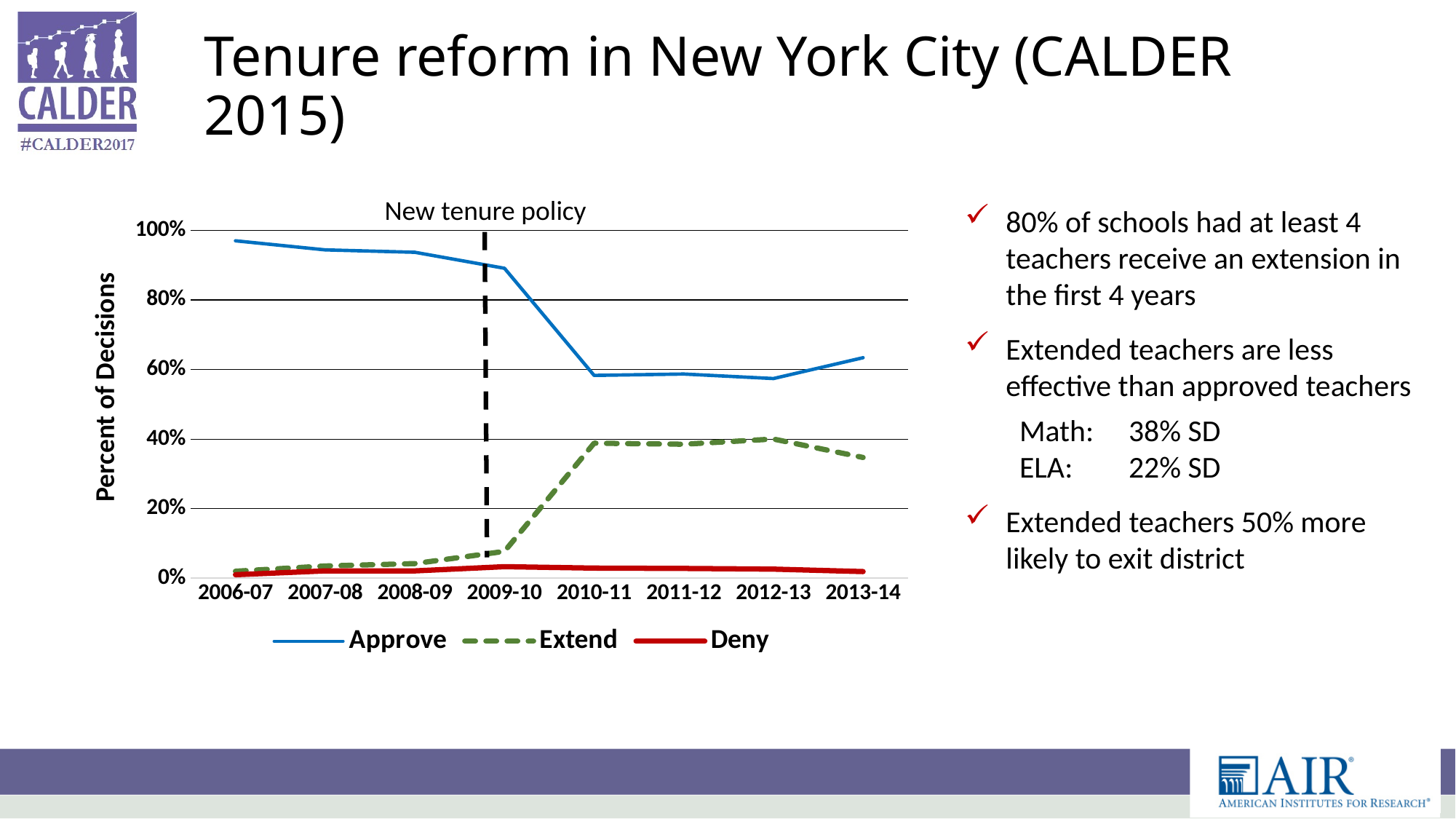
Does the Extend line rise or fall between 2008-09 and 2010-11? Rise Does the Approve line rise or fall between 2006-07 and 2010-11? Fall How many series does the chart's legend list? 3 Is the value for Approve in 2006-07 greater or less than 80%? greater Which series has the highest value in 2013-14? Approve Which series has the lowest value in 2013-14? Deny Is the value for Extend in 2010-11 greater or less than 20%? greater How many school years are shown along the x axis of the chart? 8 What kind of chart is shown on the slide? Line chart Is the value for Extend in 2006-07 greater or less than 20%? less What does the dashed vertical line on the chart mark, according to its label? New tenure policy Which is larger in 2011-12, Approve or Extend? Approve